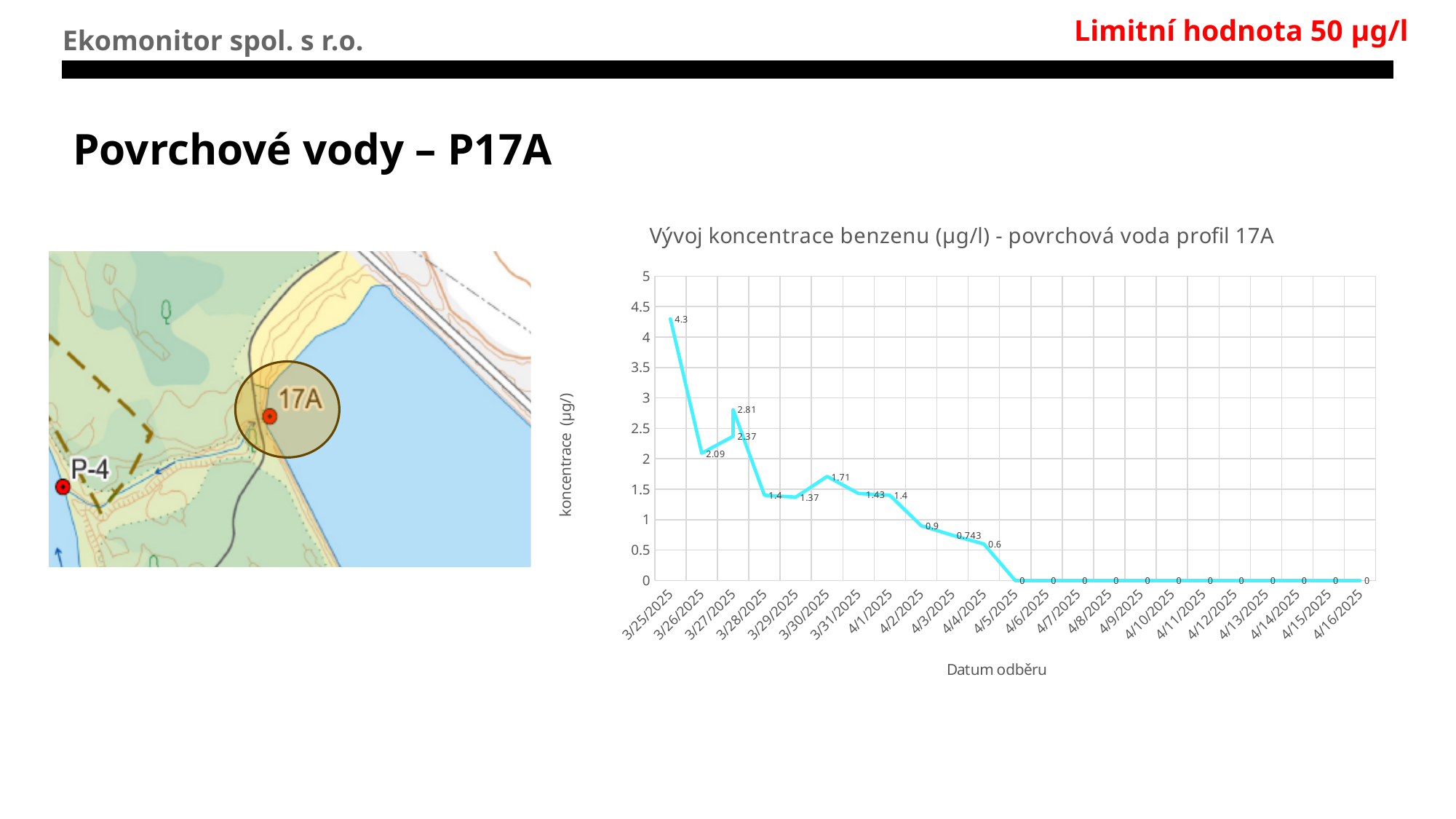
What is the lowest benzene concentration plotted on the chart? 0 What is the difference between the first value (4.3) and the value on 3/26/2025 (2.09)? 2.21 What is the title of the chart? Vývoj koncentrace benzenu (µg/l) - povrchová voda profil 17A What is the highest benzene concentration plotted on the chart? 4.3 What kind of chart is shown on the slide? line chart What is the label of the x axis of the chart? Datum odběru Is the highest value on the chart greater or less than 5? less What is the benzene concentration on 3/25/2025? 4.3 Which is larger, the value on 3/25/2025 or the value on 3/26/2025? 3/25/2025 Do the benzene concentrations generally rise or fall over the dates shown? fall What is the benzene concentration on 3/26/2025? 2.09 What is the benzene concentration on 4/16/2025? 0